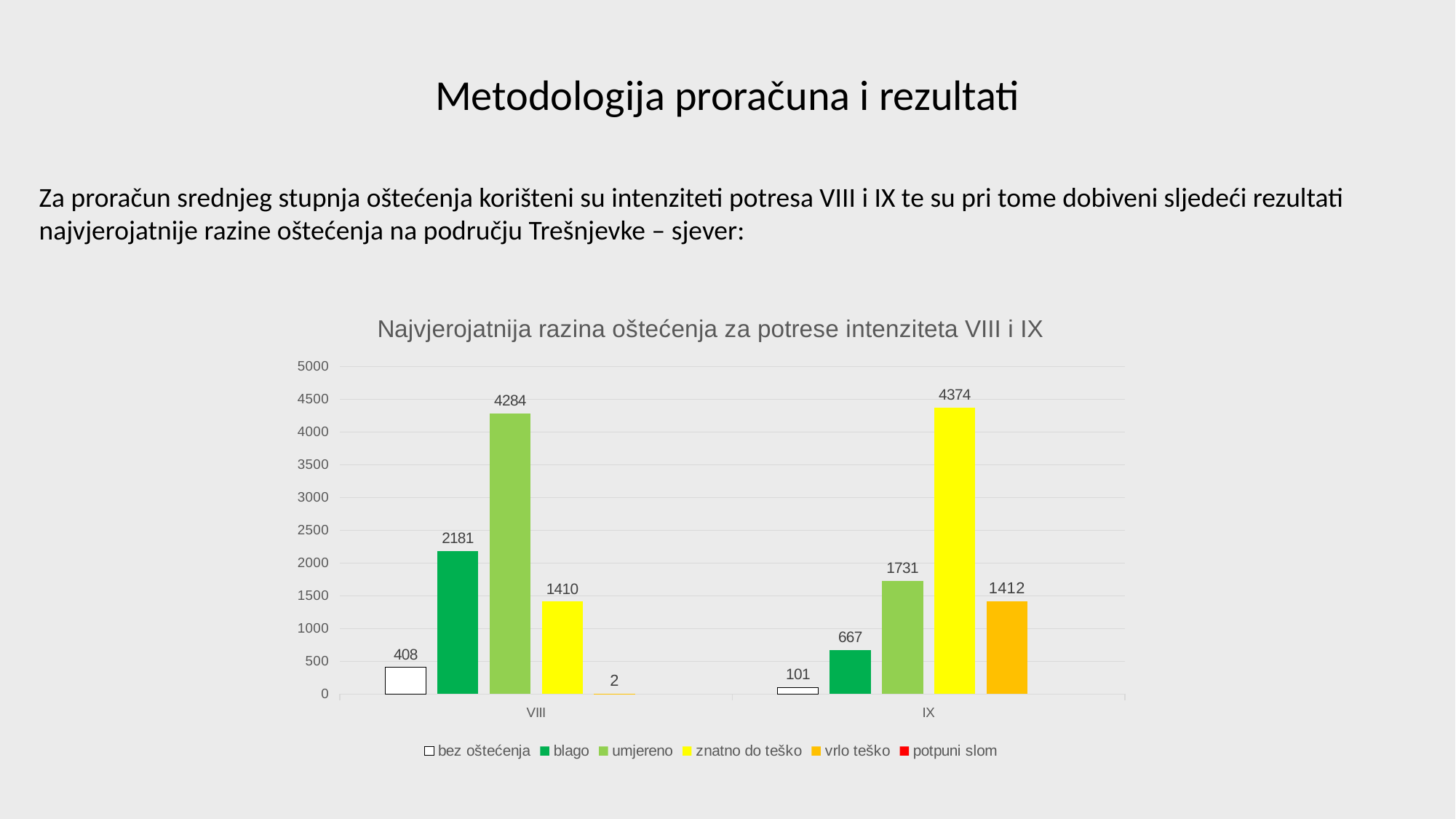
What is the value for 'znatno do teško' at intensity IX? 4374 Which is larger: 'vrlo teško' at intensity IX or 'znatno do teško' at intensity VIII? vrlo teško at intensity IX What kind of chart is shown on the slide? bar chart Which damage level has the highest value at intensity VIII? umjereno How many intensity categories are shown on the x axis? 2 Which damage level has the highest value at intensity IX? znatno do teško What is the value for 'vrlo teško' at intensity VIII? 2 How many series does the legend list? 6 What is the value for 'bez oštećenja' at intensity IX? 101 What is the title of the chart? Najvjerojatnija razina oštećenja za potrese intenziteta VIII i IX What is the difference between the 'blago' values at intensity VIII and intensity IX? 1514 What is the value for 'umjereno' at intensity VIII? 4284